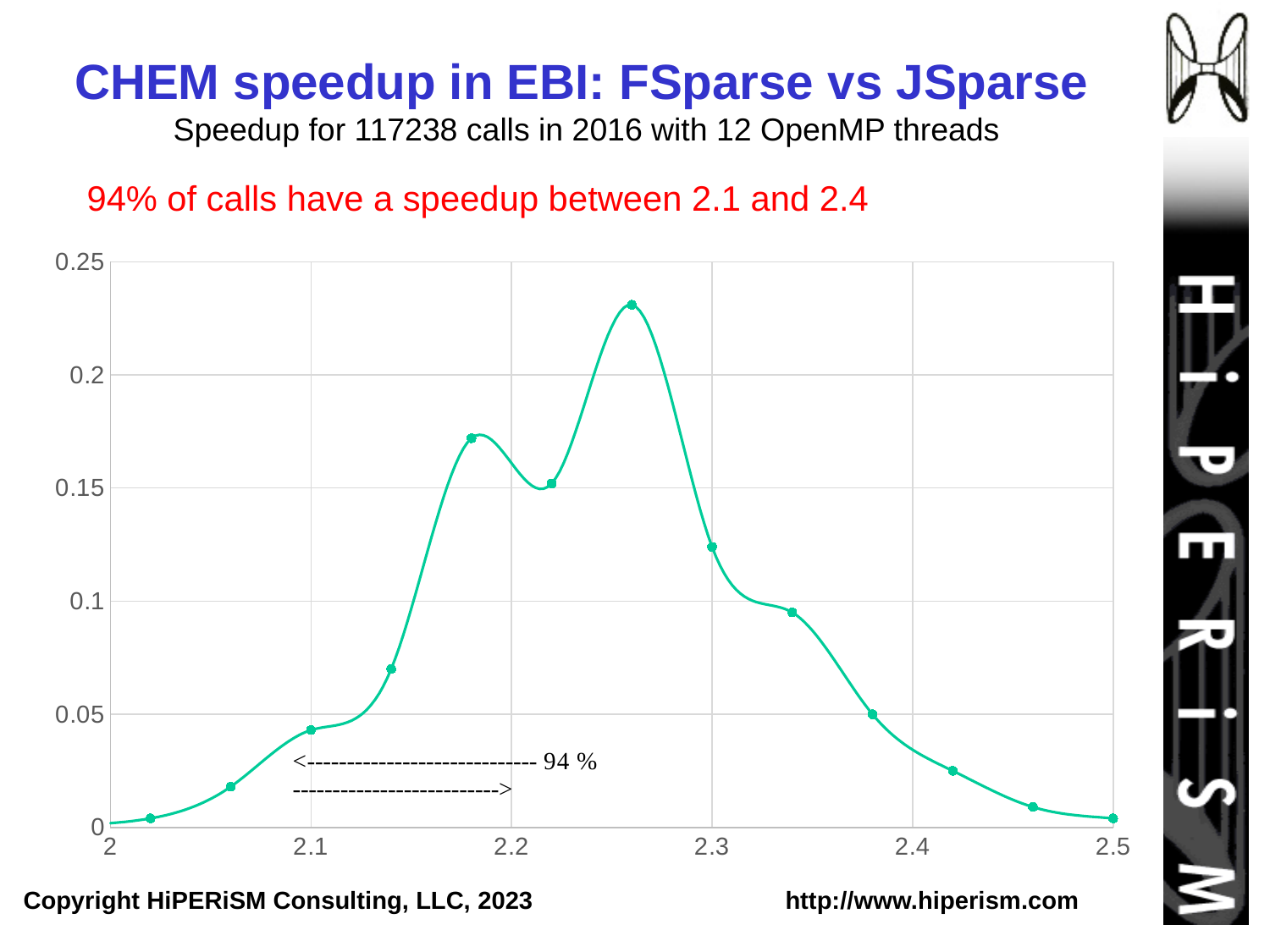
Is the value at x = 2.42 greater or less than 0.05? less What percentage is written in the annotation with the dashed arrows on the chart? 94 % Is the value at x = 2.26 greater or less than 0.2? greater Which has the larger value, the point at x = 2.18 or the point at x = 2.22? 2.18 What kind of chart is shown on the slide? line chart Does the curve rise or fall between x = 2.3 and x = 2.5? fall Is the value at x = 2.1 greater or less than 0.05? less Which has the larger value, the point at x = 2.26 or the point at x = 2.3? 2.26 What is the title of the chart slide? CHEM speedup in EBI: FSparse vs JSparse